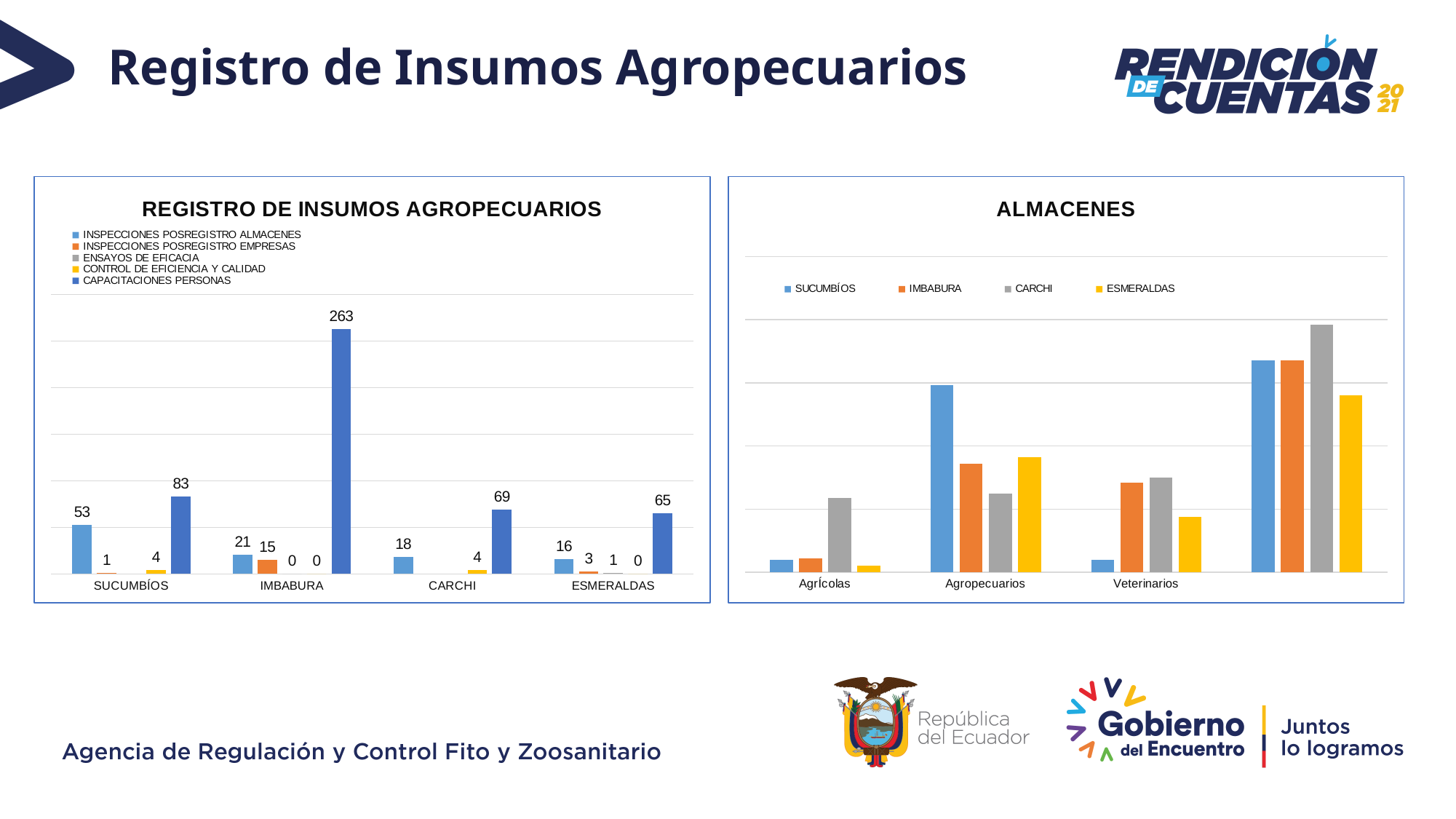
In the ALMACENES chart, how many series does the legend list? 4 In the REGISTRO DE INSUMOS AGROPECUARIOS chart, how many series does the legend list? 5 In the REGISTRO DE INSUMOS AGROPECUARIOS chart, which province has the highest value for CAPACITACIONES PERSONAS? IMBABURA In the REGISTRO DE INSUMOS AGROPECUARIOS chart, what is the value of INSPECCIONES POSREGISTRO ALMACENES for SUCUMBÍOS? 53 What kind of chart is the ALMACENES chart? Bar chart In the REGISTRO DE INSUMOS AGROPECUARIOS chart, what is the difference between the CAPACITACIONES PERSONAS values for IMBABURA and SUCUMBÍOS? 180 In the REGISTRO DE INSUMOS AGROPECUARIOS chart, what is the value of INSPECCIONES POSREGISTRO EMPRESAS for IMBABURA? 15 In the ALMACENES chart, for Veterinarios, is the bar for IMBABURA or SUCUMBÍOS larger? IMBABURA In the REGISTRO DE INSUMOS AGROPECUARIOS chart, what is the value of CAPACITACIONES PERSONAS for IMBABURA? 263 In the REGISTRO DE INSUMOS AGROPECUARIOS chart, how many provinces are shown on the x axis? 4 In the ALMACENES chart, which province has the tallest bar for Agropecuarios? SUCUMBÍOS In the REGISTRO DE INSUMOS AGROPECUARIOS chart, which province has the lowest value for CAPACITACIONES PERSONAS? ESMERALDAS